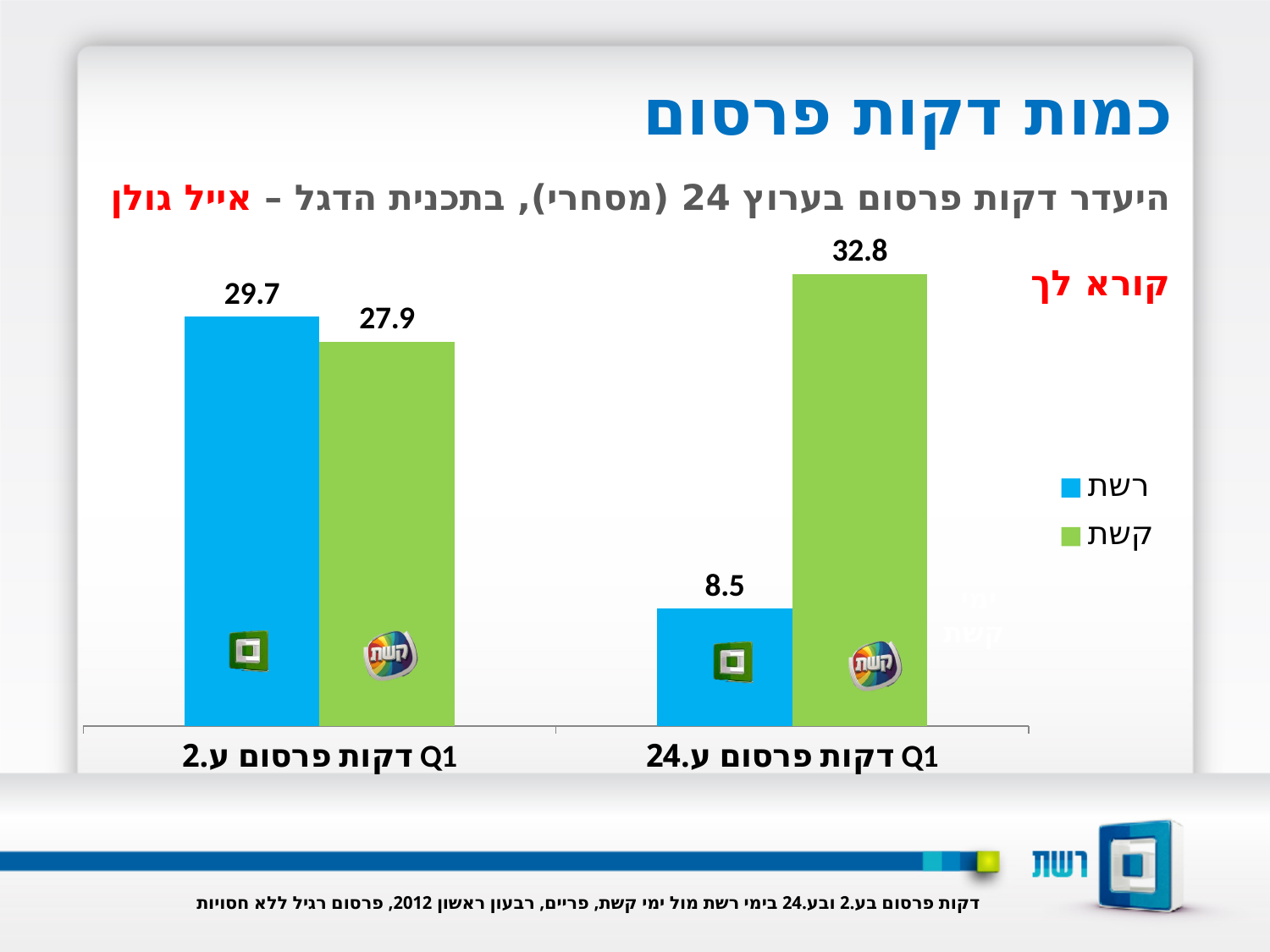
What is the value for רשת in the category Q1 דקות פרסום ע.2? 29.7 What is the value for קשת in the category Q1 דקות פרסום ע.2? 27.9 Which colour represents the series קשת in the legend? green What is the value for קשת in the category Q1 דקות פרסום ע.24? 32.8 Which bar has the lowest value in the chart? רשת in Q1 דקות פרסום ע.24 How many categories are shown on the x axis? 2 What is the value for רשת in the category Q1 דקות פרסום ע.24? 8.5 What is the difference between the קשת and רשת values in the category Q1 דקות פרסום ע.24? 24.3 In the category Q1 דקות פרסום ע.2, which series has the larger value, רשת or קשת? רשת How many series does the legend list? 2 What type of chart is shown on the slide? bar chart Which bar has the highest value in the chart? קשת in Q1 דקות פרסום ע.24